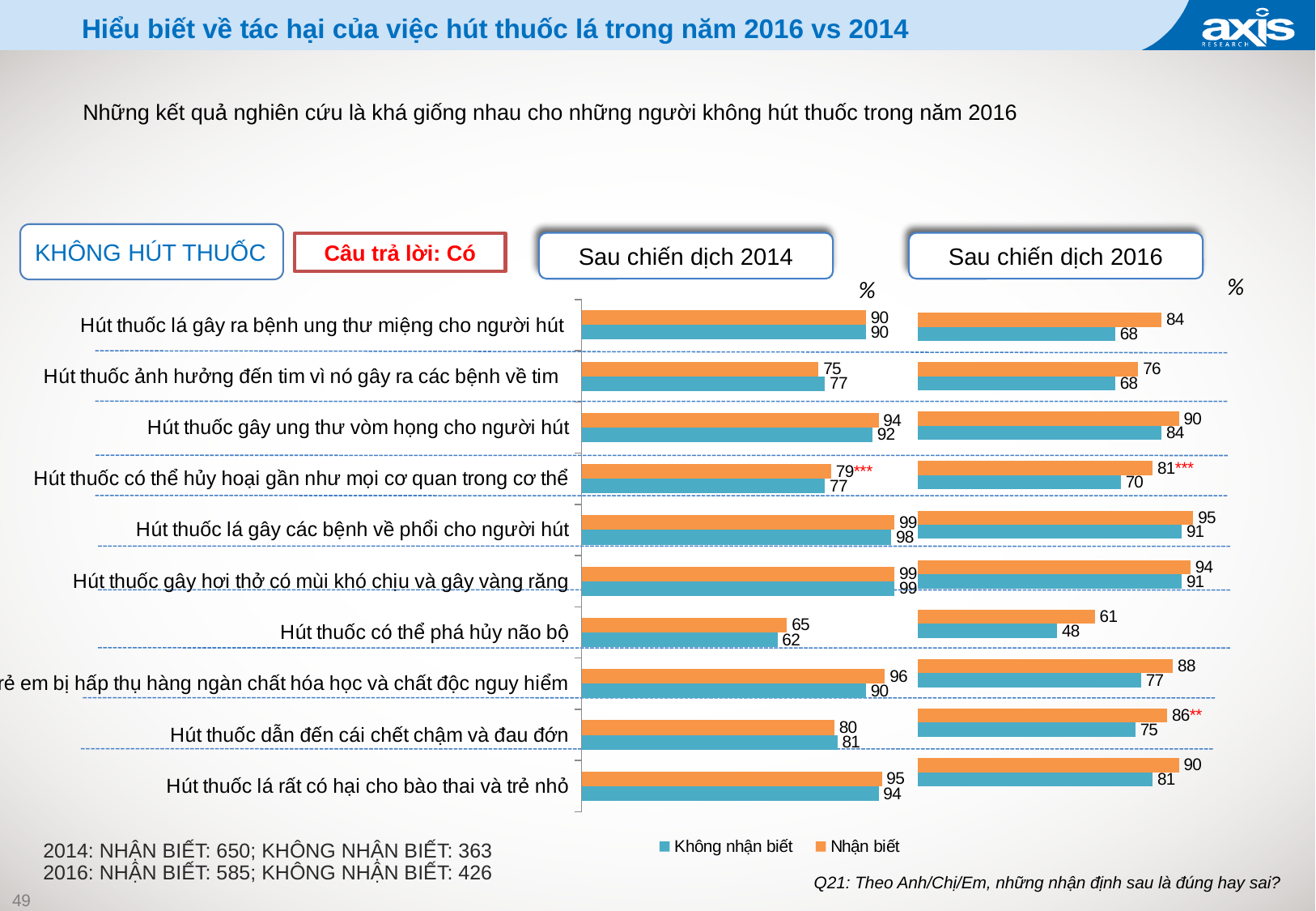
What type of chart is the 'Sau chiến dịch 2016' chart? Bar chart In the 'Sau chiến dịch 2014' chart, what is the value of 'Nhận biết' for 'Hút thuốc có thể phá hủy não bộ'? 65 In the 'Sau chiến dịch 2016' chart, which category has the highest 'Nhận biết' value? Hút thuốc lá gây các bệnh về phổi cho người hút In the 'Sau chiến dịch 2016' chart, which is larger for 'Hút thuốc có thể phá hủy não bộ': 'Nhận biết' or 'Không nhận biết'? Nhận biết How many categories are shown in the 'Sau chiến dịch 2014' chart? 10 In the 'Sau chiến dịch 2014' chart, what is the difference between 'Nhận biết' and 'Không nhận biết' for 'Trẻ em bị hấp thụ hàng ngàn chất hóa học và chất độc nguy hiểm'? 6 In the 'Sau chiến dịch 2016' chart, what is the value of 'Nhận biết' for 'Hút thuốc dẫn đến cái chết chậm và đau đớn'? 86 Which colour represents 'Nhận biết' in the charts? Orange In the 'Sau chiến dịch 2016' chart, what is the difference between 'Nhận biết' and 'Không nhận biết' for 'Hút thuốc lá gây ra bệnh ung thư miệng cho người hút'? 16 In the 'Sau chiến dịch 2016' chart, what is the value of 'Không nhận biết' for 'Hút thuốc có thể phá hủy não bộ'? 48 How many series does the legend list for the charts? 2 In the 'Sau chiến dịch 2014' chart, which category has the lowest 'Không nhận biết' value? Hút thuốc có thể phá hủy não bộ